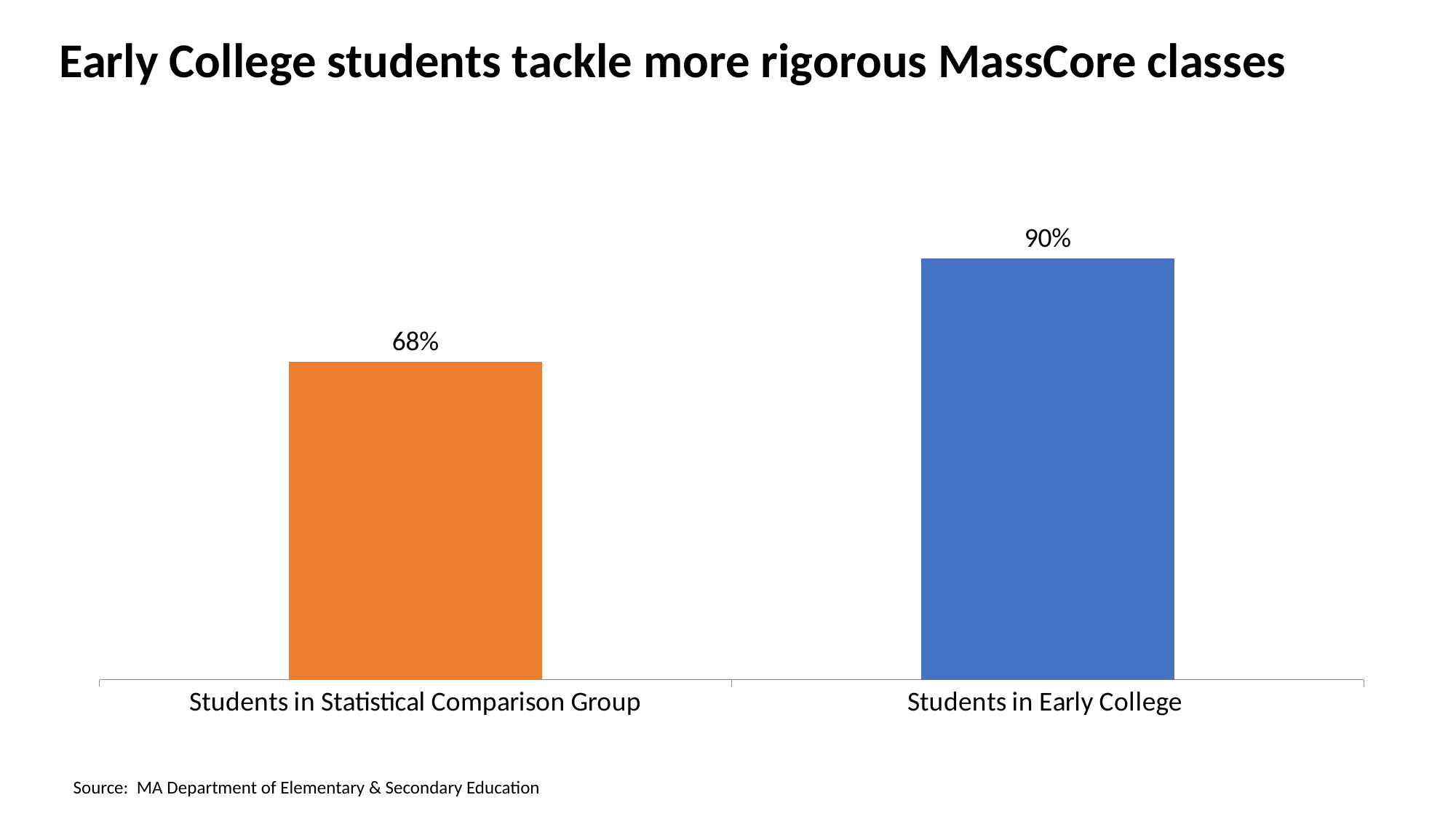
What is the difference between the value for Students in Early College and the value for Students in Statistical Comparison Group? 22% What kind of chart is shown on the slide? bar chart Which category has the lowest value? Students in Statistical Comparison Group What colour is the bar for Students in Early College? blue Which is larger: the value for Students in Early College or the value for Students in Statistical Comparison Group? Students in Early College What is the title of the slide? Early College students tackle more rigorous MassCore classes What is the value for Students in Statistical Comparison Group? 68% What is the value for Students in Early College? 90% Which category has the highest value? Students in Early College How many categories are shown in the chart? 2